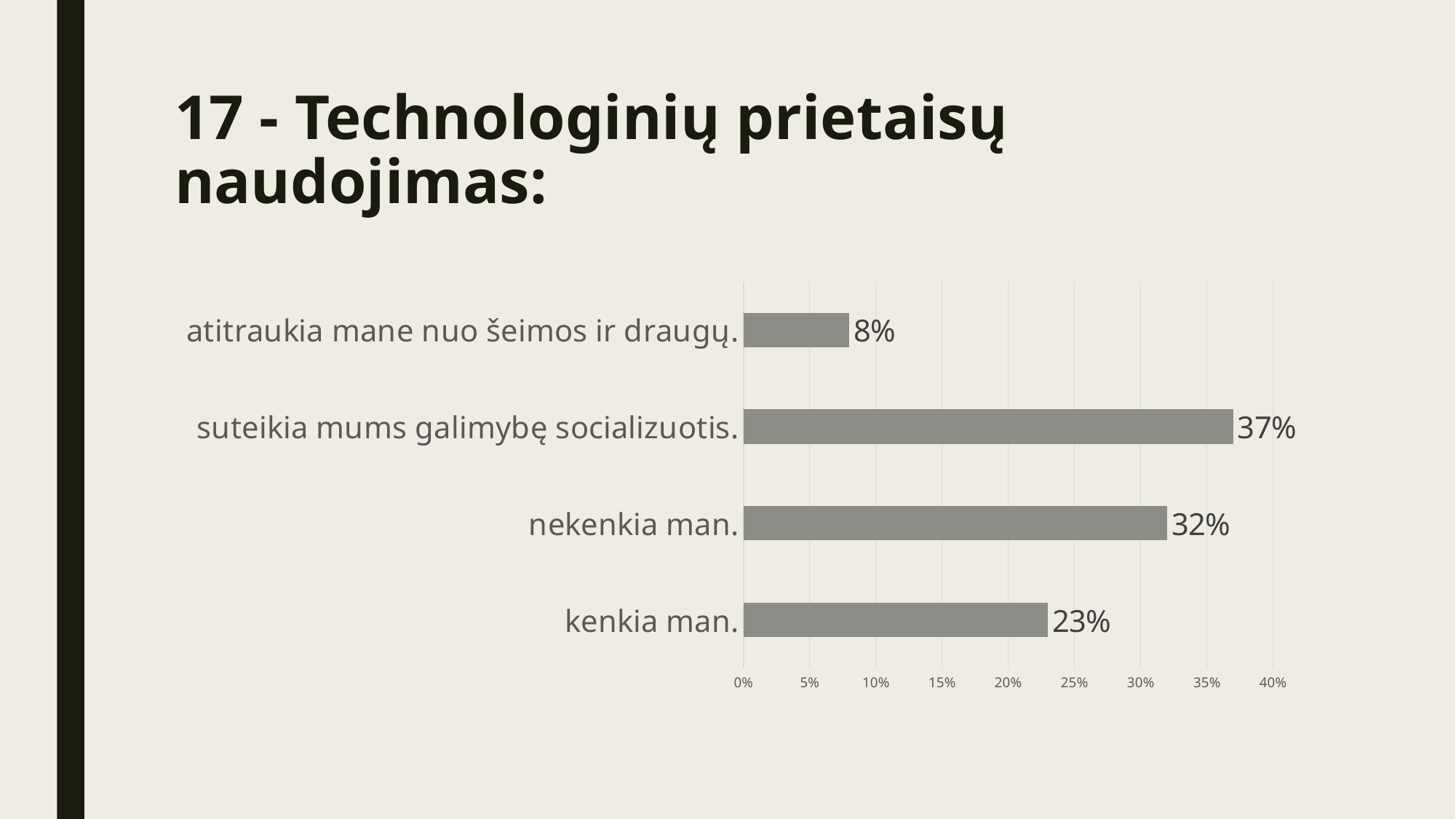
Which category has the lowest value? atitraukia mane nuo šeimos ir draugų. What is the value for "kenkia man."? 23% What is the value for "nekenkia man."? 32% What is the difference between the values for "nekenkia man." and "kenkia man."? 9% What is the difference between the values for "suteikia mums galimybę socializuotis." and "nekenkia man."? 5% Which is larger, the value for "kenkia man." or the value for "nekenkia man."? nekenkia man. How many categories are shown in the chart? 4 What is the value for "atitraukia mane nuo šeimos ir draugų."? 8% What kind of chart is shown on the slide? bar chart What is the value for "suteikia mums galimybę socializuotis."? 37% Which category has the highest value? suteikia mums galimybę socializuotis. Is the value for "kenkia man." greater or less than 25%? less